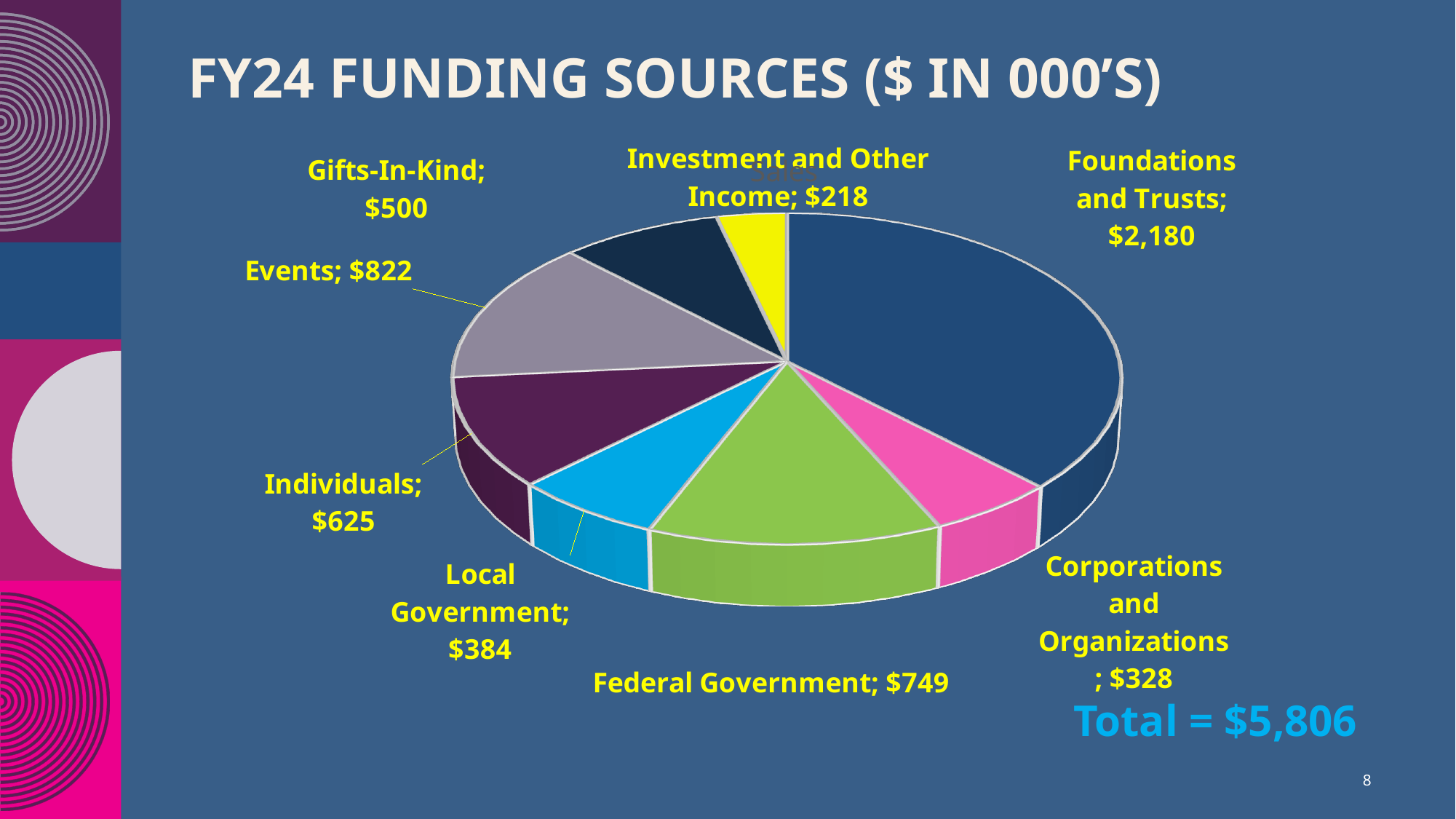
Which funding source has the smallest slice of the pie? Investment and Other Income What is the value for Federal Government? $749 Which funding source has the largest slice of the pie? Foundations and Trusts What is the value for Local Government? $384 Which is larger, Federal Government or Events? Events What is the difference between the Foundations and Trusts value and the Federal Government value? $1,431 What is the total of all funding sources shown on the slide? $5,806 What kind of chart is shown on the slide? Pie chart What is the difference between the Events value and the Individuals value? $197 How many funding source slices are shown in the pie chart? 8 What is the value for Foundations and Trusts? $2,180 What is the value for Investment and Other Income? $218